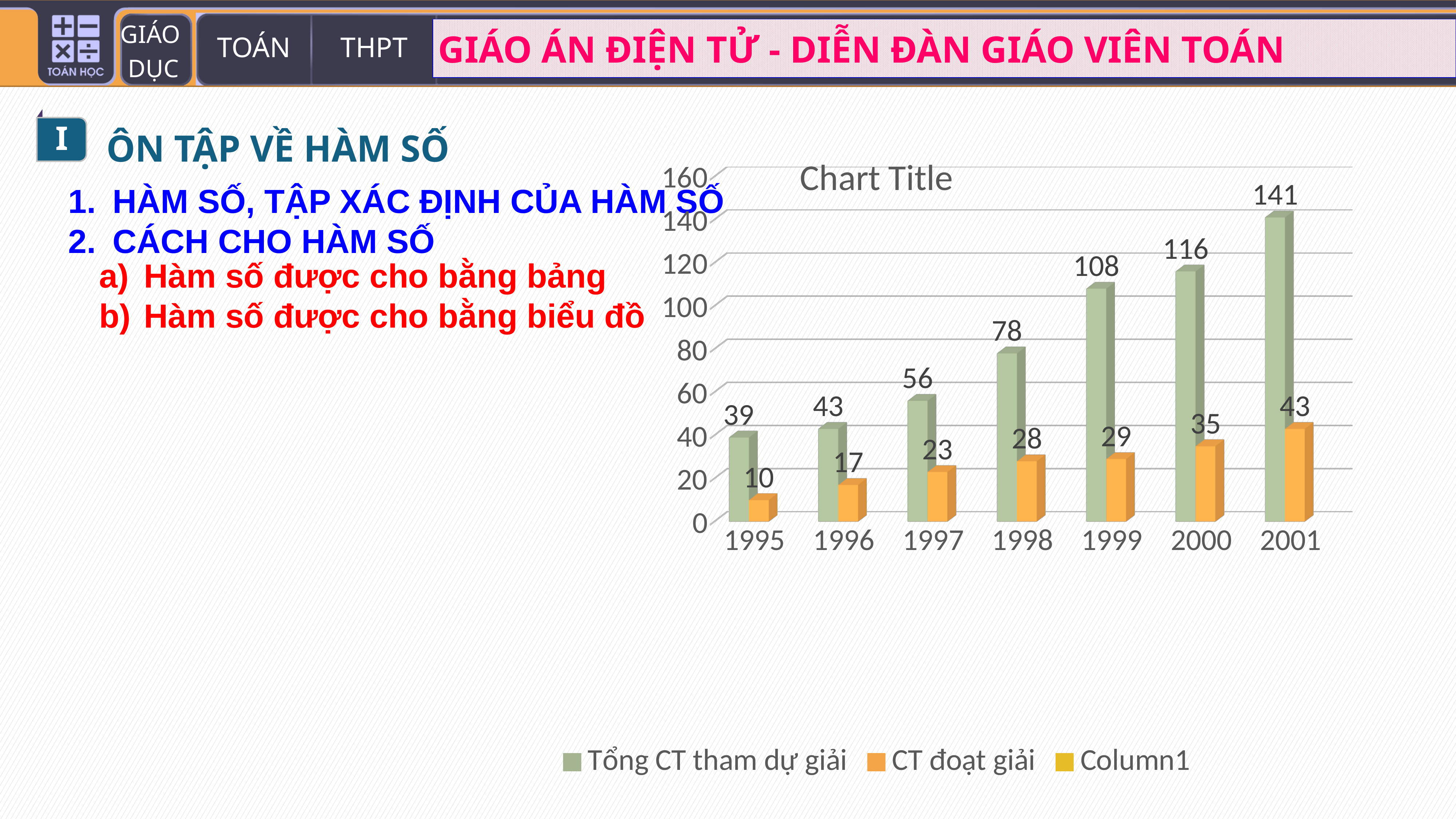
What is the difference between the "CT đoạt giải" values for 2001 and 1996? 26 Which is larger: "Tổng CT tham dự giải" in 1997 or "CT đoạt giải" in 2001? Tổng CT tham dự giải in 1997 What kind of chart is shown on the slide? Bar chart Do the values of "Tổng CT tham dự giải" rise or fall from 1995 to 2001? Rise What is the difference between "Tổng CT tham dự giải" and "CT đoạt giải" in 1999? 79 Which year has the highest value for "Tổng CT tham dự giải"? 2001 What is the value of "CT đoạt giải" for 2000? 35 How many years are shown on the x axis? 7 What is the value of "Tổng CT tham dự giải" for 1998? 78 What is the value of "Tổng CT tham dự giải" for 1995? 39 How many series does the legend list? 3 Which year has the lowest value for "CT đoạt giải"? 1995